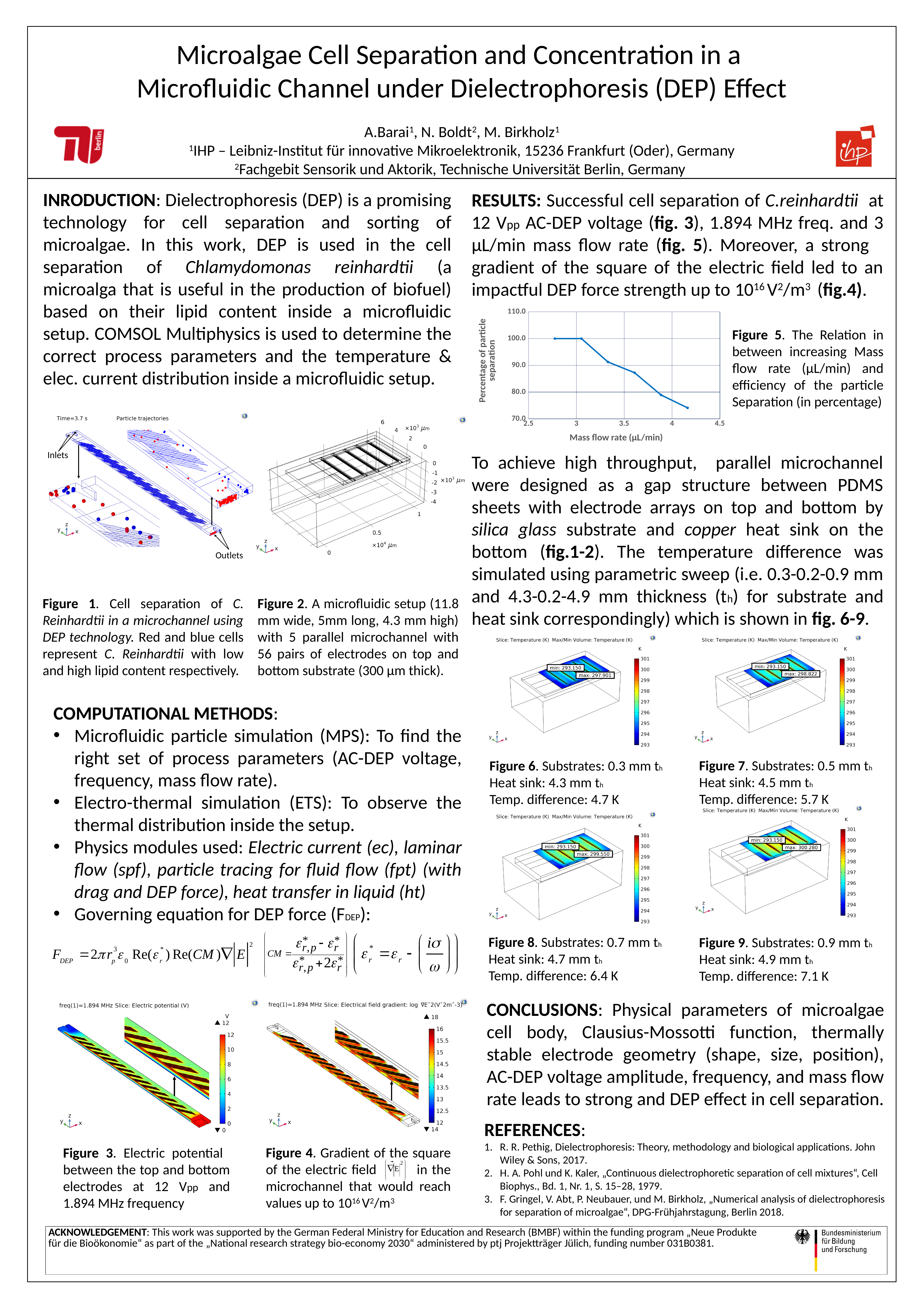
How many data points are plotted on the line in Figure 5? 6 In Figure 5, does the percentage of particle separation rise or fall as the mass flow rate increases? fall In Figure 5, what is the label of the x axis? Mass flow rate (μL/min) In Figure 5, which has the higher percentage of particle separation: the point at about 3 μL/min or the point at about 4 μL/min? the point at about 3 μL/min In Figure 5, what is the label of the y axis? Percentage of particle separation In Figure 5, what is the highest value shown on the y axis? 110.0 In Figure 5, is the percentage of particle separation at the highest plotted mass flow rate greater or less than 70.0? greater In Figure 5, is the percentage of particle separation at the highest plotted mass flow rate greater or less than 80.0? less What kind of chart is Figure 5? line chart In Figure 5, is the percentage of particle separation at a mass flow rate of about 3.6 μL/min greater or less than 90.0? less In Figure 5, what is the percentage of particle separation at the lowest plotted mass flow rate? 100.0